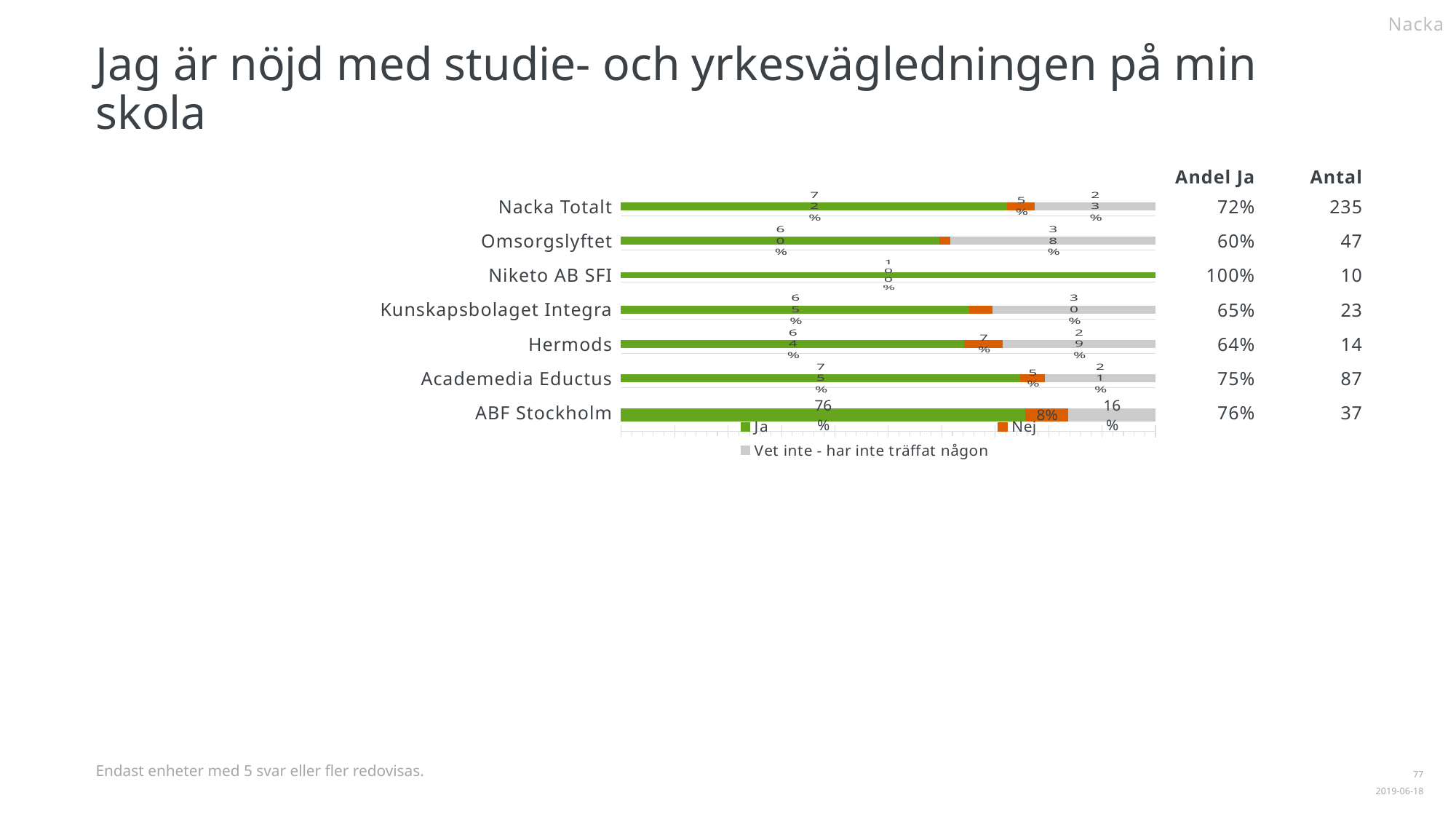
What is the 'Antal' (number of respondents) shown for Nacka Totalt? 235 What is the 'Ja' share for Nacka Totalt? 72% What is the difference between the 'Ja' share of ABF Stockholm and that of Hermods? 12 percentage points What is the 'Nej' share for Hermods? 7% What type of chart is shown on the slide? Stacked bar chart What is the 'Vet inte - har inte träffat någon' share for Omsorgslyftet? 38% Which has a larger 'Ja' share, Academedia Eductus or Kunskapsbolaget Integra? Academedia Eductus How many categories (rows) are plotted in the chart? 7 Which category has the highest 'Ja' share? Niketo AB SFI How many series does the legend list? 3 What is the 'Nej' share for ABF Stockholm? 8% Which category has the lowest 'Ja' share? Omsorgslyftet